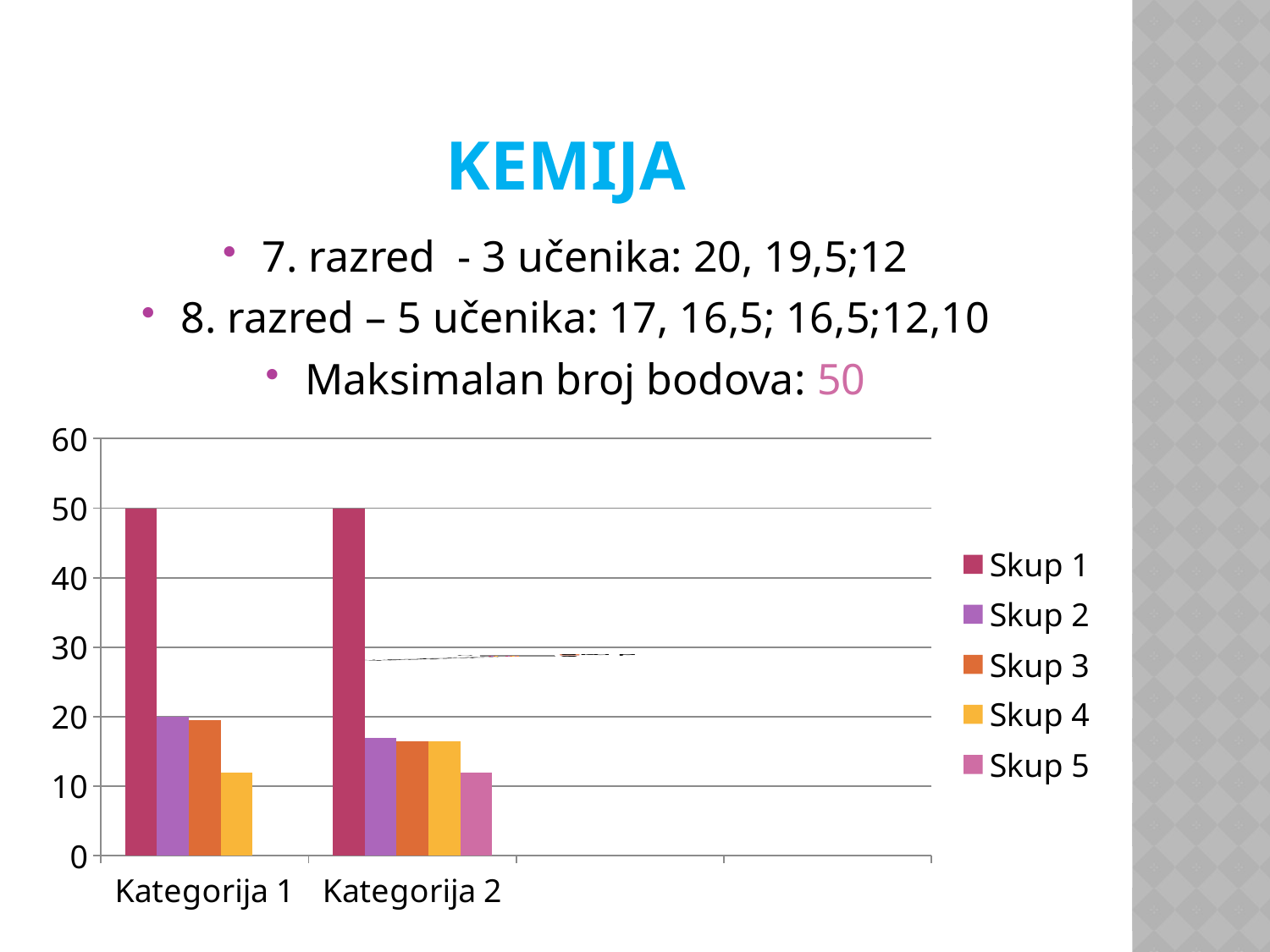
How many series does the chart legend list? 5 How many categories are shown on the x axis of the chart? 2 Which series has the highest value in Kategorija 2? Skup 1 What is the value of Skup 1 for Kategorija 1? 50 Is the value for Skup 5 in Kategorija 2 greater or less than 10? greater What kind of chart is shown on the slide? bar chart What is the value of Skup 2 for Kategorija 1? 20 In Kategorija 1, which is larger: Skup 2 or Skup 4? Skup 2 Which series has the lowest value in Kategorija 1? Skup 4 Is the value for Skup 3 in Kategorija 2 greater or less than 20? less What is the value of Skup 1 for Kategorija 2? 50 Which series has the lowest value in Kategorija 2? Skup 5